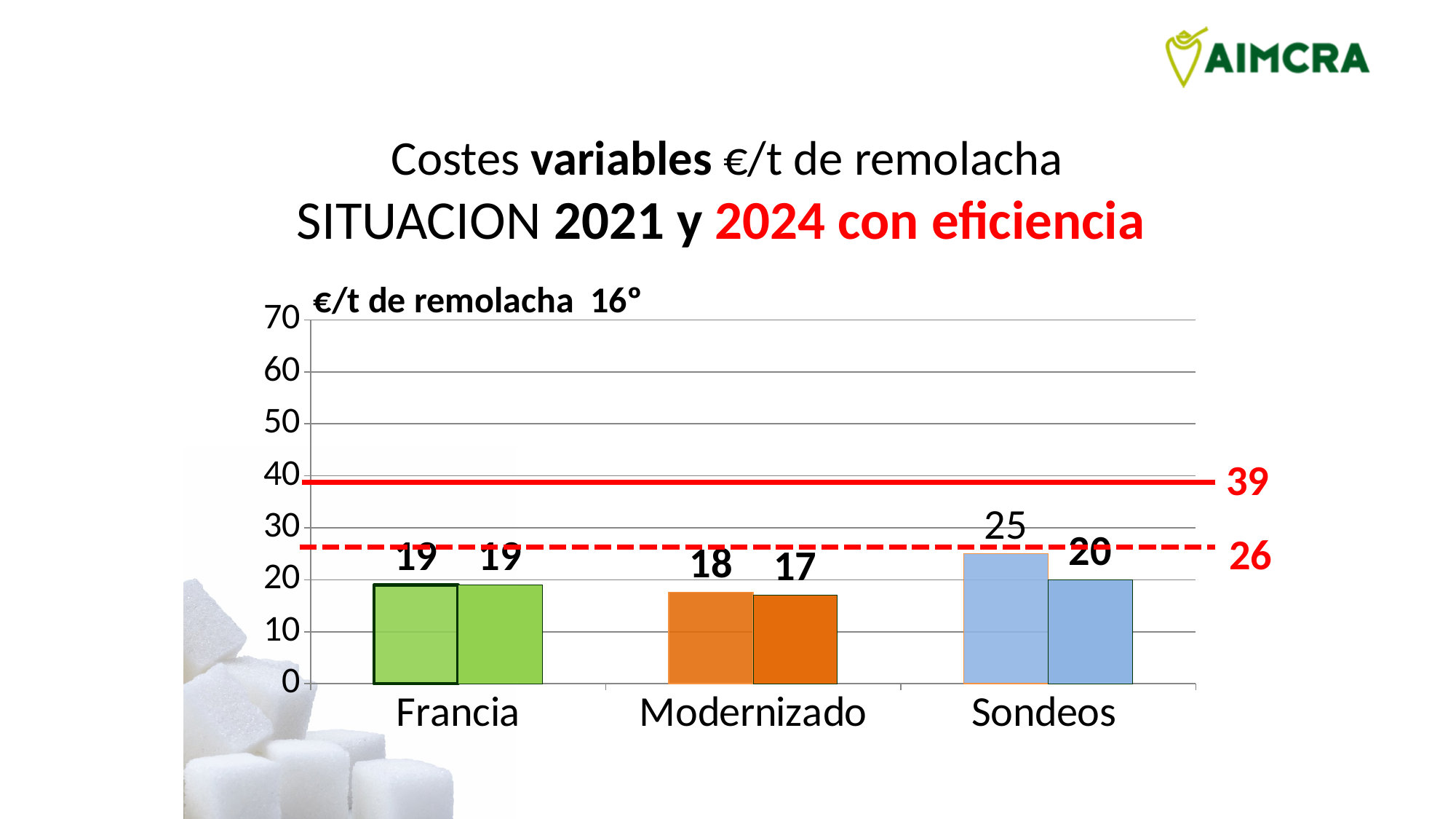
What value is marked by the dashed red horizontal line on the chart? 26 What is the value of the left bar for Sondeos? 25 What type of chart is shown on the slide? bar chart How many categories are shown on the x axis of the chart? 3 What is the difference between the left and right bars for Sondeos? 5 Which is larger, the right bar for Francia or the right bar for Modernizado? Francia Which category has the highest bar in the chart? Sondeos What is the value of the right bar for Sondeos? 20 What is the value of the right bar for Modernizado? 17 What is the difference between the left bar for Sondeos and the left bar for Modernizado? 7 What is the value of the left bar for Francia? 19 What value is marked by the solid red horizontal line on the chart? 39